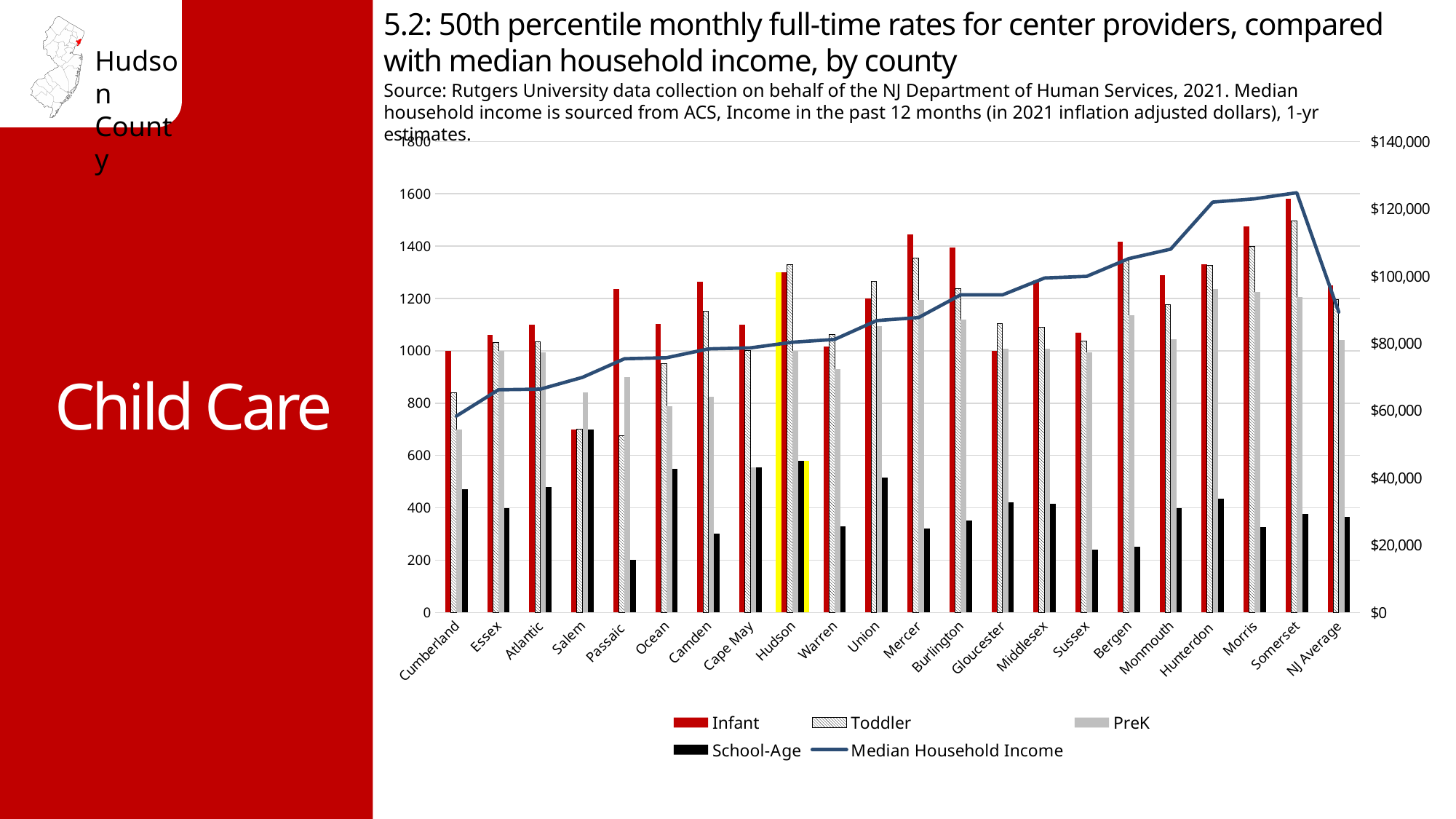
How many categories are shown along the x axis? 22 Which county has the lowest School-Age rate? Passaic Is the School-Age rate for Hudson greater or less than 400? greater Is the Median Household Income for Cumberland greater or less than $60,000? less Which county has the highest Median Household Income? Somerset What kind of chart is shown on the slide? bar chart with a line Which county has the lowest Infant rate? Salem How many series does the legend list? 5 Does the Median Household Income line generally rise or fall from Cumberland to Somerset? rise Which county has the highest Infant rate? Somerset Is the Infant rate for Mercer greater or less than 1400? greater Which is larger, the School-Age rate for Salem or the School-Age rate for Passaic? Salem